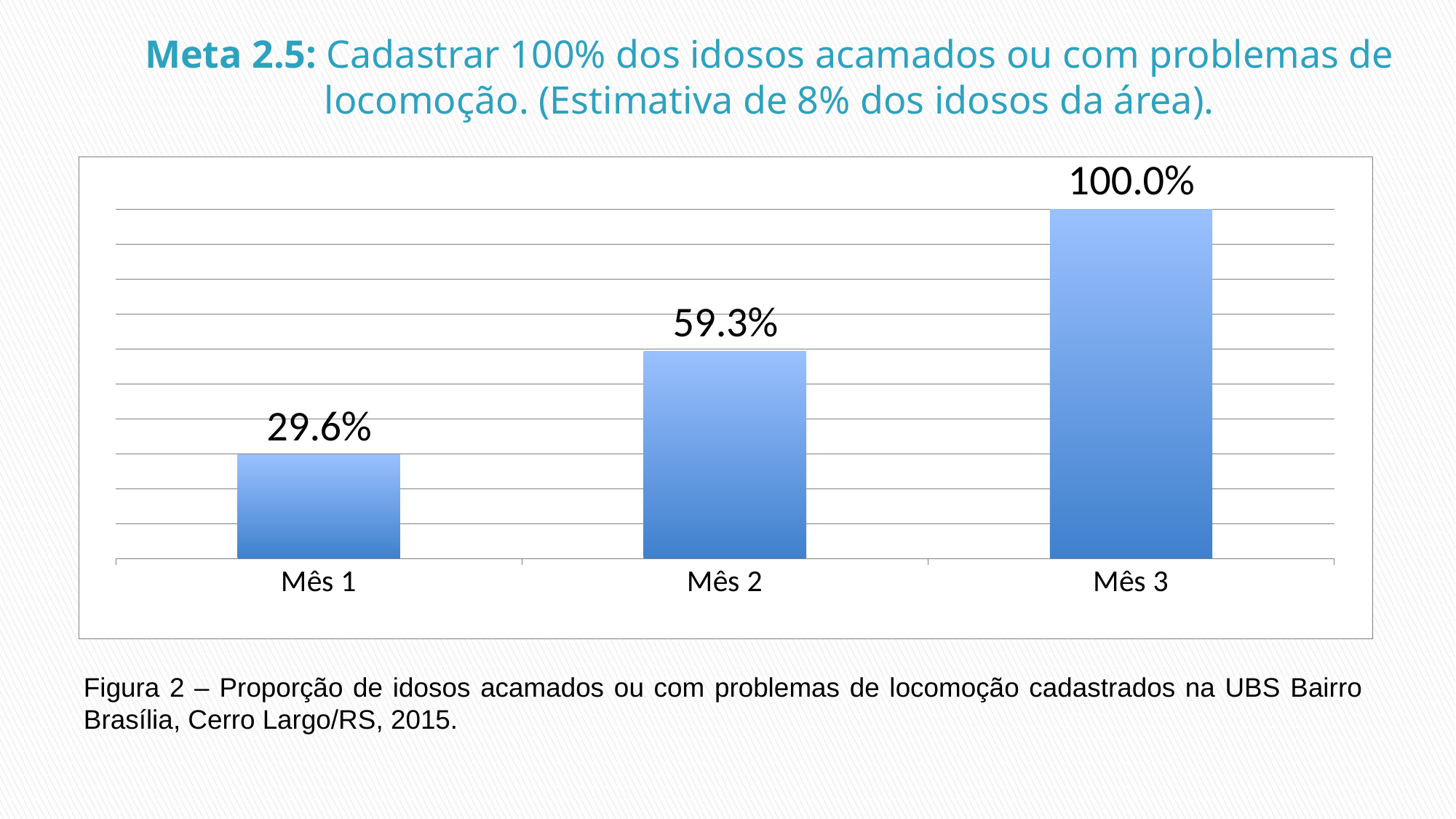
How many categories are shown on the x axis? 3 What kind of chart is shown on the slide? Bar chart What is the difference between the values for Mês 2 and Mês 1? 29.7% What is the value for Mês 2? 59.3% What is the value for Mês 1? 29.6% Which is larger, the value for Mês 1 or the value for Mês 2? Mês 2 Which month has the lowest value? Mês 1 What is the difference between the values for Mês 3 and Mês 2? 40.7% Which month has the highest value? Mês 3 Do the values rise or fall from Mês 1 to Mês 3? Rise What is the value for Mês 3? 100.0% What is the figure number given in the caption below the chart? Figura 2